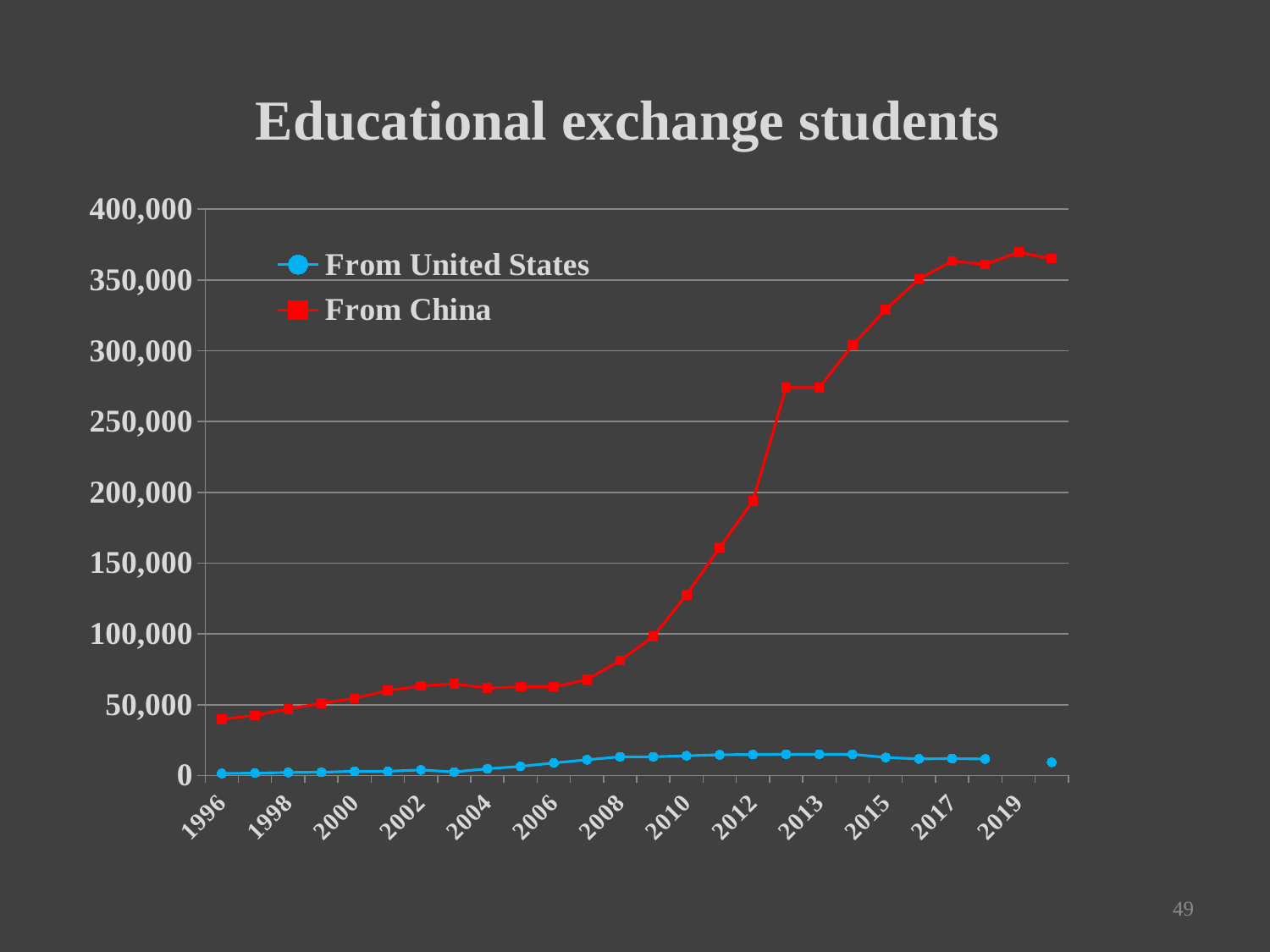
In 1996, which series has the higher value, From United States or From China? From China Does the From China series rise or fall overall from 1996 to 2019? rise What is the title of the chart? Educational exchange students What kind of chart is shown on the slide? line chart Is the value for From China in 2019 greater or less than 350,000? greater Is the value for From China in 2015 greater or less than 250,000? greater What colour is the line for From China? red How many series does the legend list? 2 Is the value for From China in 2008 greater or less than 100,000? less